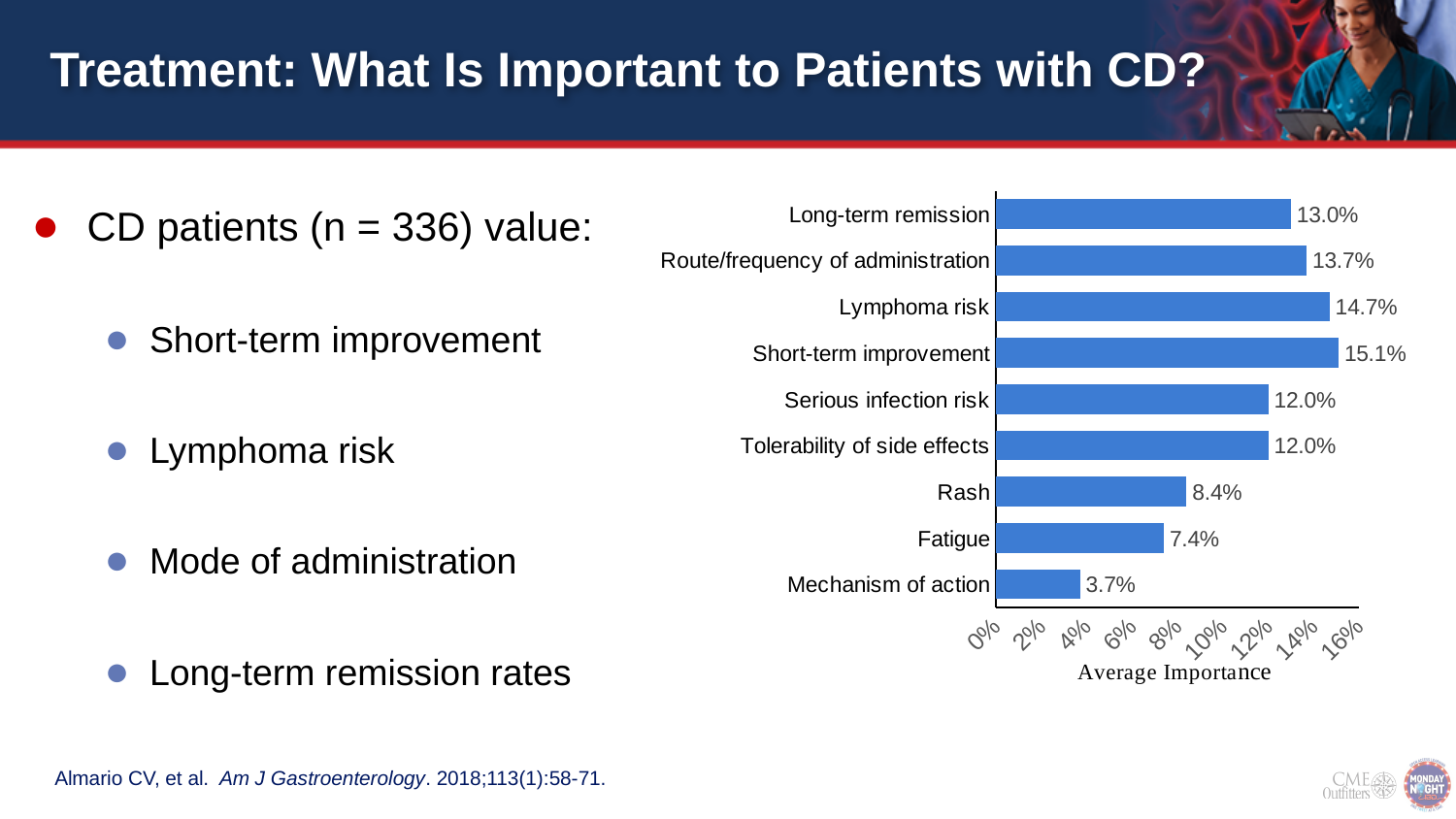
How many categories are shown in the chart? 9 What is the average importance value for Route/frequency of administration? 13.7% What is the average importance value for Lymphoma risk? 14.7% Which category has the highest average importance? Short-term improvement What is the difference between the values for Short-term improvement and Long-term remission? 2.1% What is the average importance value for Mechanism of action? 3.7% What kind of chart is shown on the slide? Bar chart Is the value for Serious infection risk greater or less than 10%? greater What is the label of the horizontal axis of the chart? Average Importance What is the difference between the values for Rash and Fatigue? 1.0% Which is larger, the value for Rash or the value for Fatigue? Rash Which category has the lowest average importance? Mechanism of action